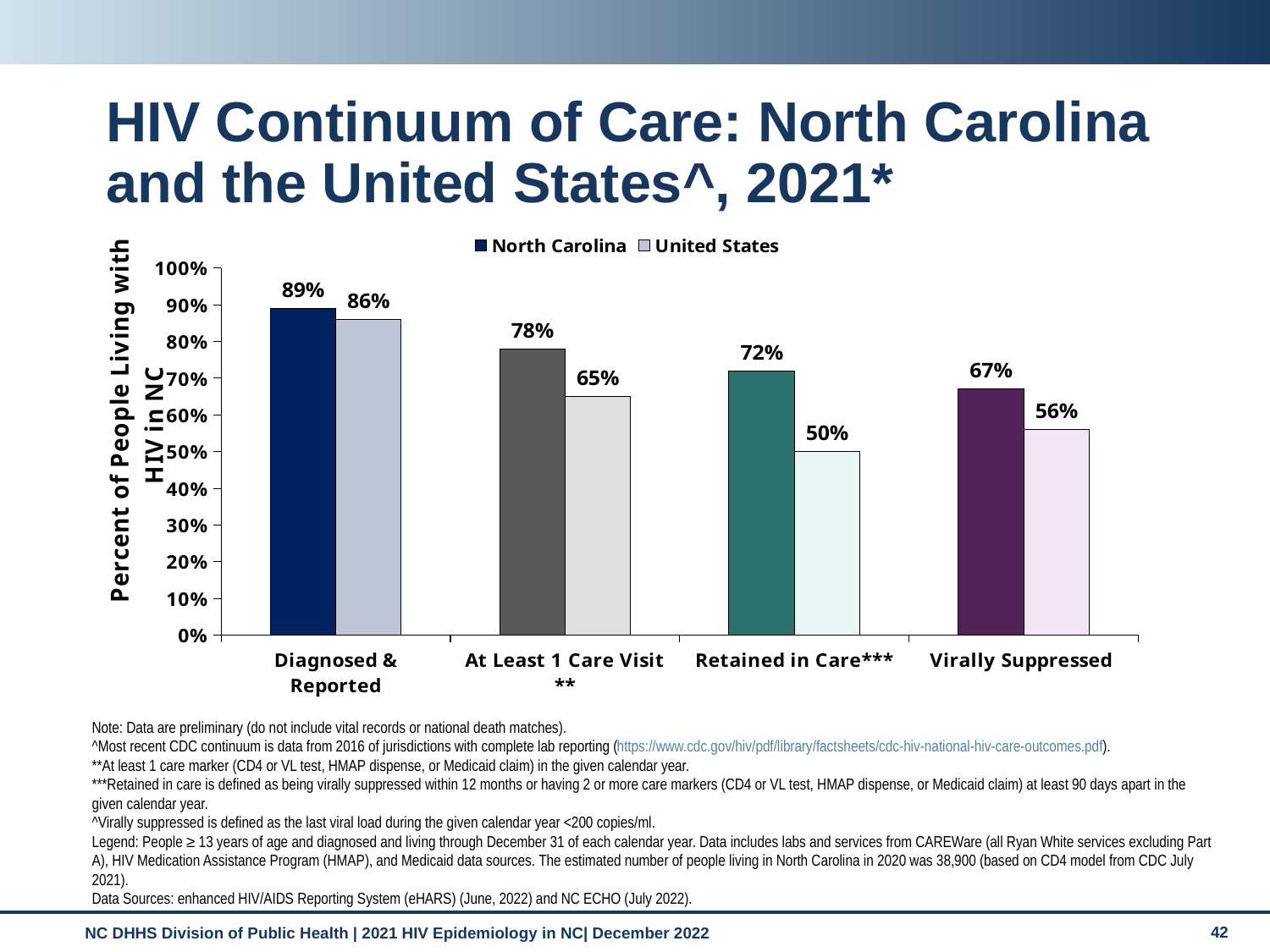
What is the difference between the North Carolina and United States values for At Least 1 Care Visit **? 13% How many categories are shown on the x axis? 4 What kind of chart is shown on the slide? Bar chart What is the North Carolina value for Diagnosed & Reported? 89% What is the United States value for Retained in Care***? 50% Do the North Carolina values rise or fall from left to right across the categories? Fall How many series does the legend list? 2 Which is larger for Virally Suppressed: the North Carolina value or the United States value? North Carolina What is the difference between the North Carolina and United States values for Retained in Care***? 22% What is the United States value for Virally Suppressed? 56% Which category has the highest United States value? Diagnosed & Reported Which category has the lowest North Carolina value? Virally Suppressed